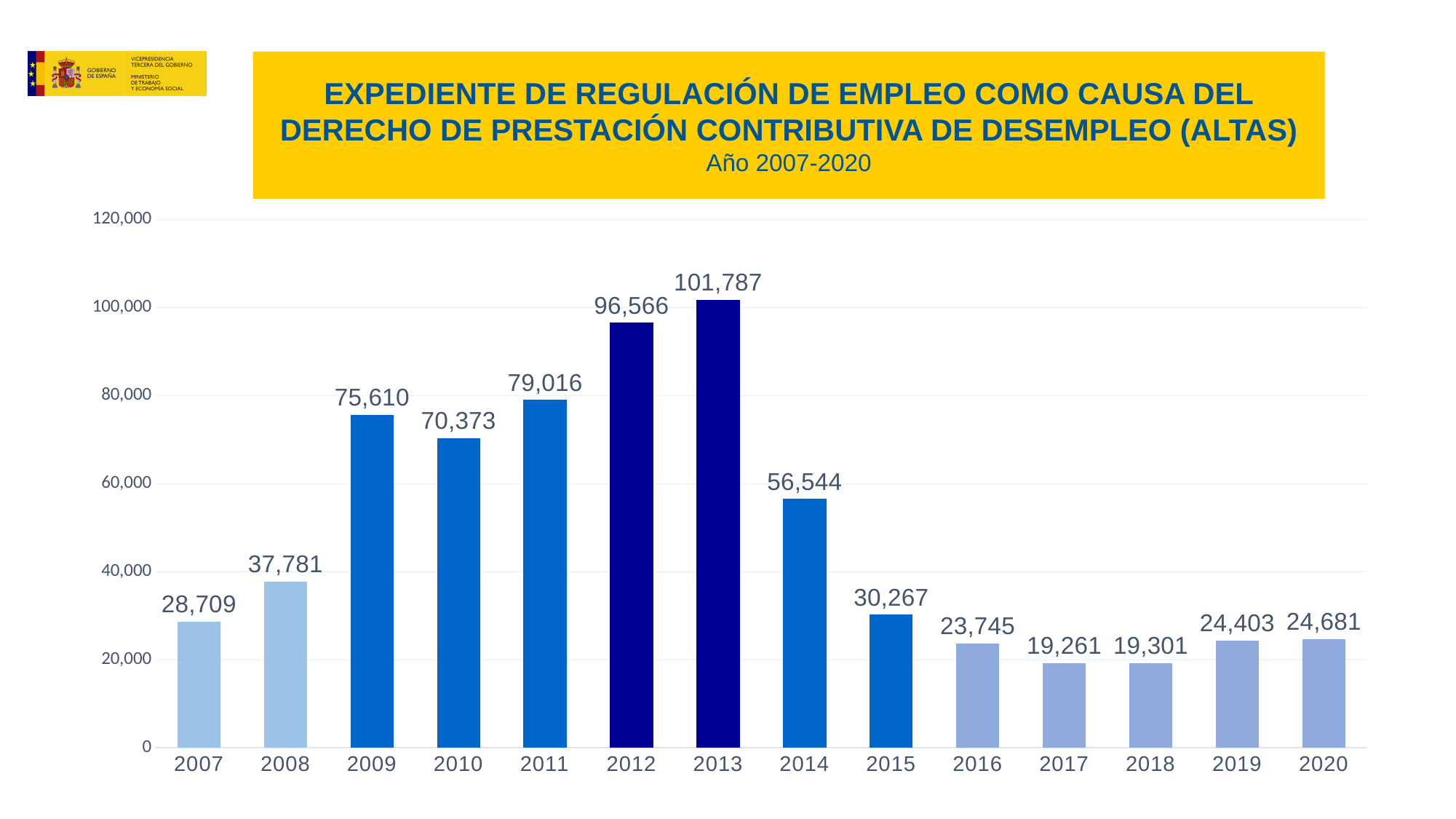
What is the value for 2013? 101,787 What is the difference between the values for 2013 and 2012? 5,221 What is the value for 2020? 24,681 How many years are shown on the x axis? 14 What is the difference between the values for 2009 and 2008? 37,829 Do the values rise or fall from 2013 to 2017? Fall Which year has the highest value? 2013 Is the value for 2014 greater or less than 40,000? greater What kind of chart is shown on the slide? Bar chart What is the value for 2007? 28,709 Which is larger, the value for 2009 or the value for 2010? 2009 Which year has the lowest value? 2017